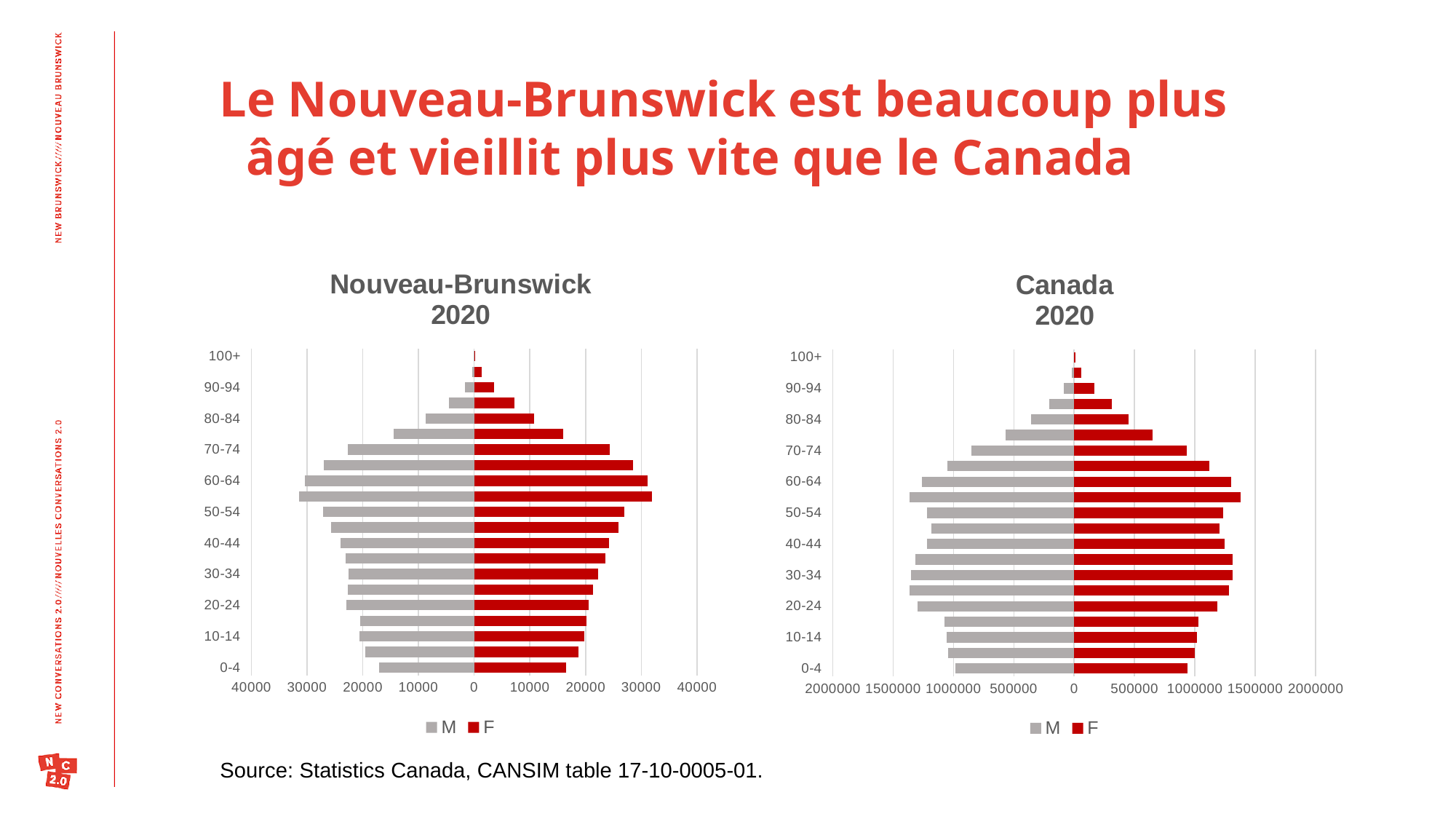
In the Canada 2020 chart, is the M value for 80-84 greater or less than 500000? less In the Nouveau-Brunswick 2020 chart, is the F value for 0-4 greater or less than 20000? less In the Nouveau-Brunswick 2020 chart, which is larger for the F series: 70-74 or 0-4? 70-74 In the Nouveau-Brunswick 2020 chart, what are the two legend entries? M and F In the Canada 2020 chart, which is larger for the M series: 30-34 or 70-74? 30-34 How many series does the legend of the Canada 2020 chart list? 2 In the Canada 2020 chart, which colour represents the F series? red What kind of chart is the Nouveau-Brunswick 2020 chart? bar chart In the Nouveau-Brunswick 2020 chart, is the F value for 70-74 greater or less than 20000? greater In the Nouveau-Brunswick 2020 chart, which is larger for the M series: 20-24 or 80-84? 20-24 In the Nouveau-Brunswick 2020 chart, do the M bars get longer or shorter going from 60-64 up to 100+? shorter